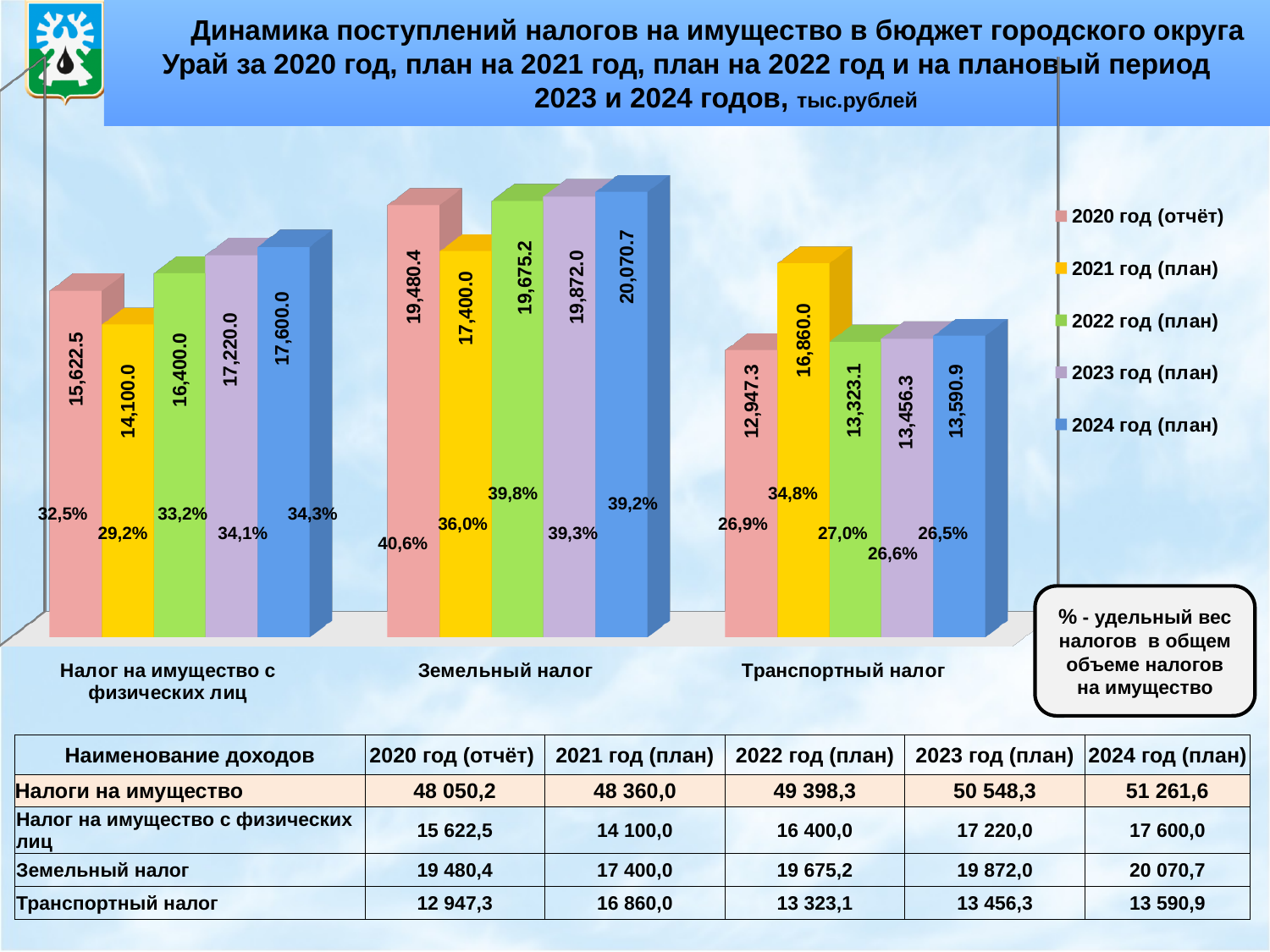
What is the difference between the 2024 год (план) and 2021 год (план) values for Земельный налог? 2,670.7 What colour represents the 2021 год (план) series in the chart? yellow For Налог на имущество с физических лиц, do the values rise or fall from 2021 год (план) to 2024 год (план)? rise How many tax categories are shown on the x axis of the chart? 3 What is the value for Транспортный налог in the 2021 год (план) series? 16,860.0 What is the value for Земельный налог in the 2024 год (план) series? 20,070.7 What is the value for Налог на имущество с физических лиц in the 2023 год (план) series? 17,220.0 Which series has the lowest value for Налог на имущество с физических лиц? 2021 год (план) How many series does the chart legend list? 5 Which category has the highest value in the 2020 год (отчёт) series? Земельный налог For Транспортный налог, which is larger: the 2021 год (план) value or the 2024 год (план) value? 2021 год (план) What kind of chart is shown on the slide? bar chart